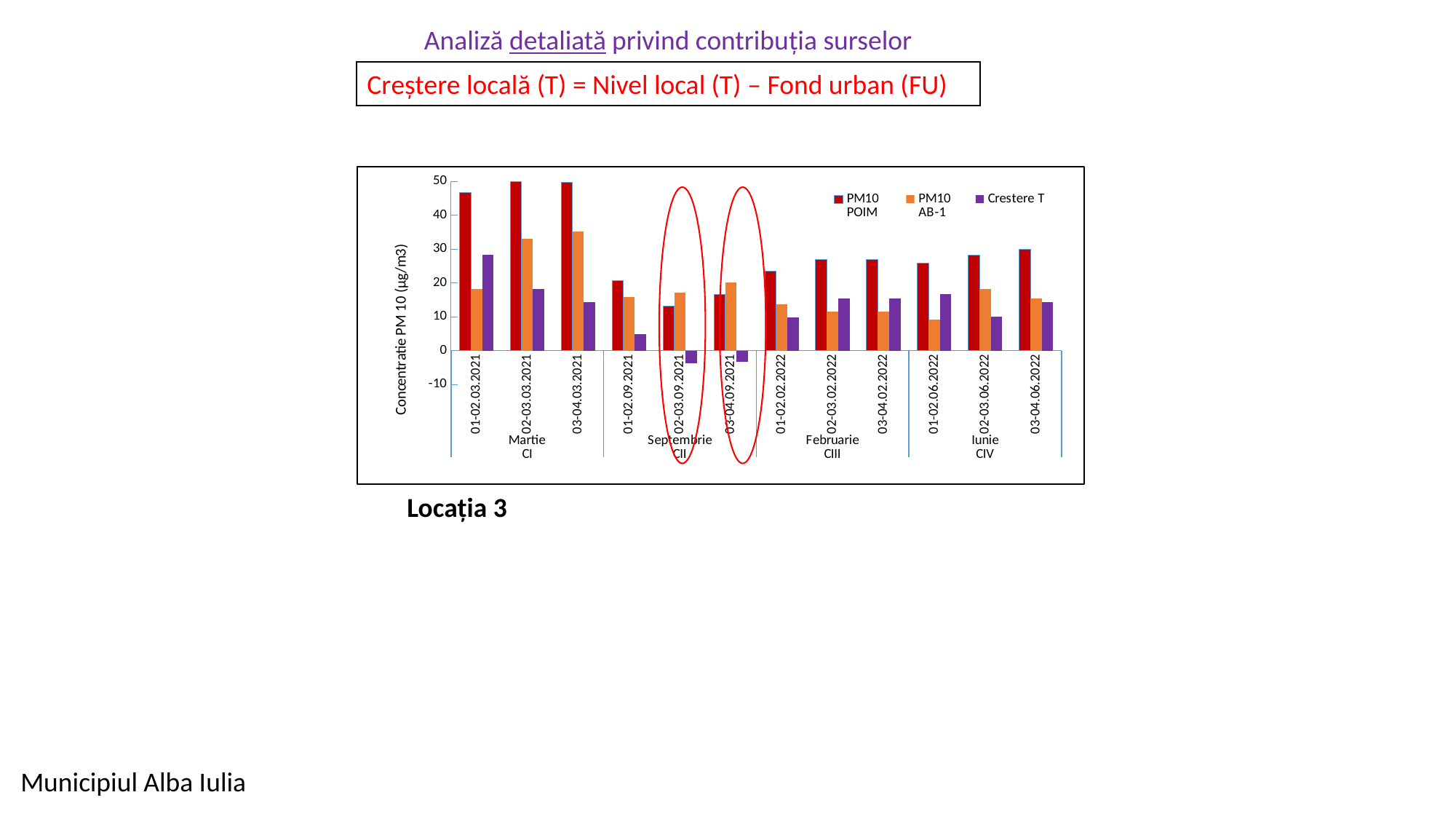
What is the label of the vertical axis? Concentratie PM 10 (µg/m3) How many date categories are plotted along the x axis? 12 How many series does the legend list? 3 Is the PM10 AB-1 value for 02-03.02.2022 greater or less than 20? less Which date has the highest Crestere T value? 01-02.03.2021 Which date has the lowest PM10 AB-1 value? 01-02.06.2022 Is the Crestere T value for 02-03.09.2021 greater or less than 0? less For 03-04.09.2021, which is larger: PM10 POIM or PM10 AB-1? PM10 AB-1 Is the PM10 POIM value for 01-02.03.2021 greater or less than 40? greater What kind of chart is shown on the slide? bar chart For 02-03.03.2021, which is larger: PM10 AB-1 or Crestere T? PM10 AB-1 Which date has the lowest PM10 POIM value? 02-03.09.2021